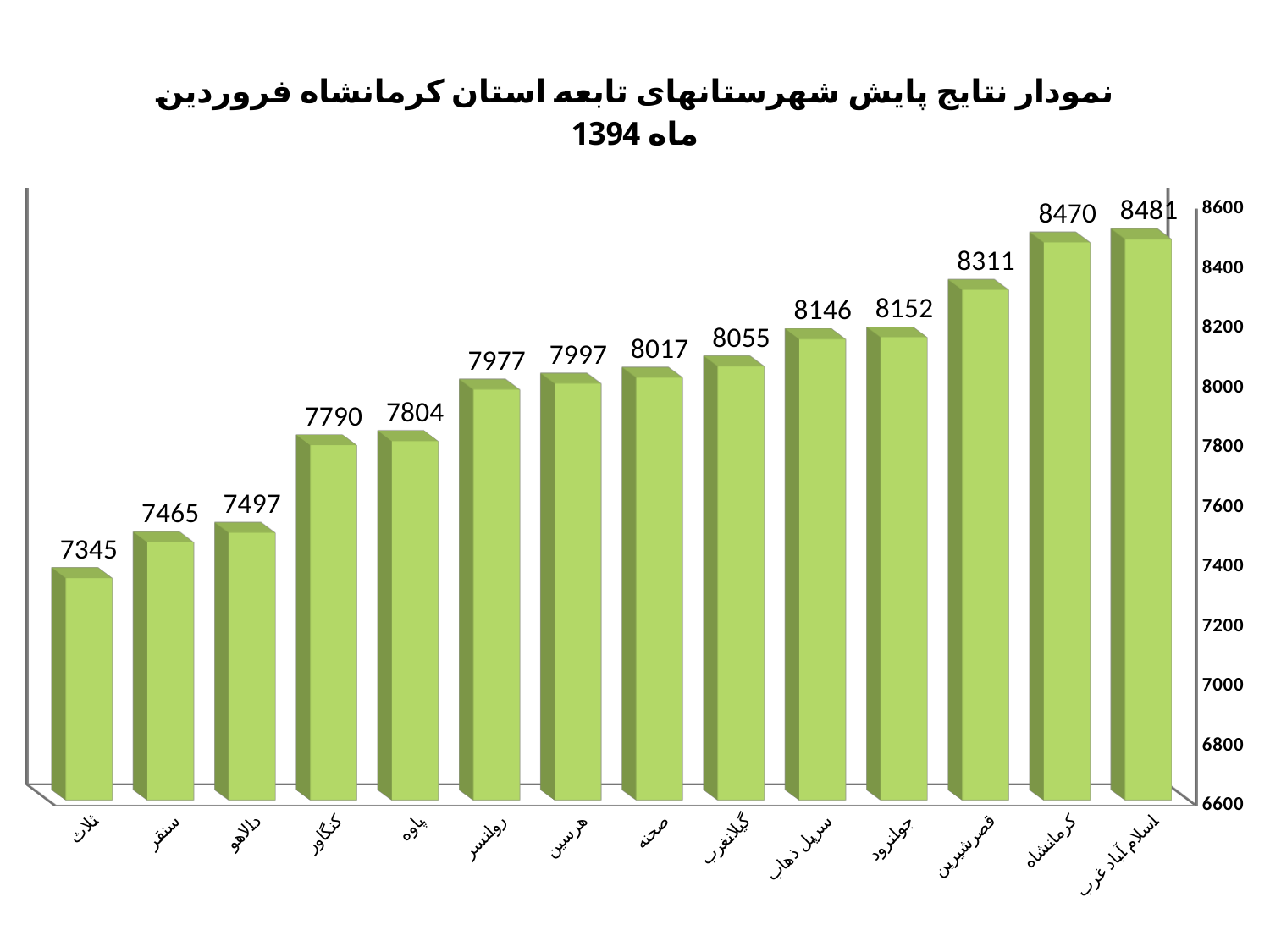
What is the value for گیلانغرب? 8055 Is the value for سنقر greater or less than 7600? less What is the value for کرمانشاه? 8470 What is the difference between the values for اسلام آباد غرب and ثلاث? 1136 What is the difference between the values for قصرشیرین and جوانرود? 159 Which category has the highest value? اسلام آباد غرب Which is larger, the value for کنگاور or the value for هرسین? هرسین How many categories are shown on the x axis? 14 What kind of chart is shown on the slide? bar chart Which category has the lowest value? ثلاث What is the value for پاوه? 7804 Do the values rise or fall from left to right along the x axis? rise